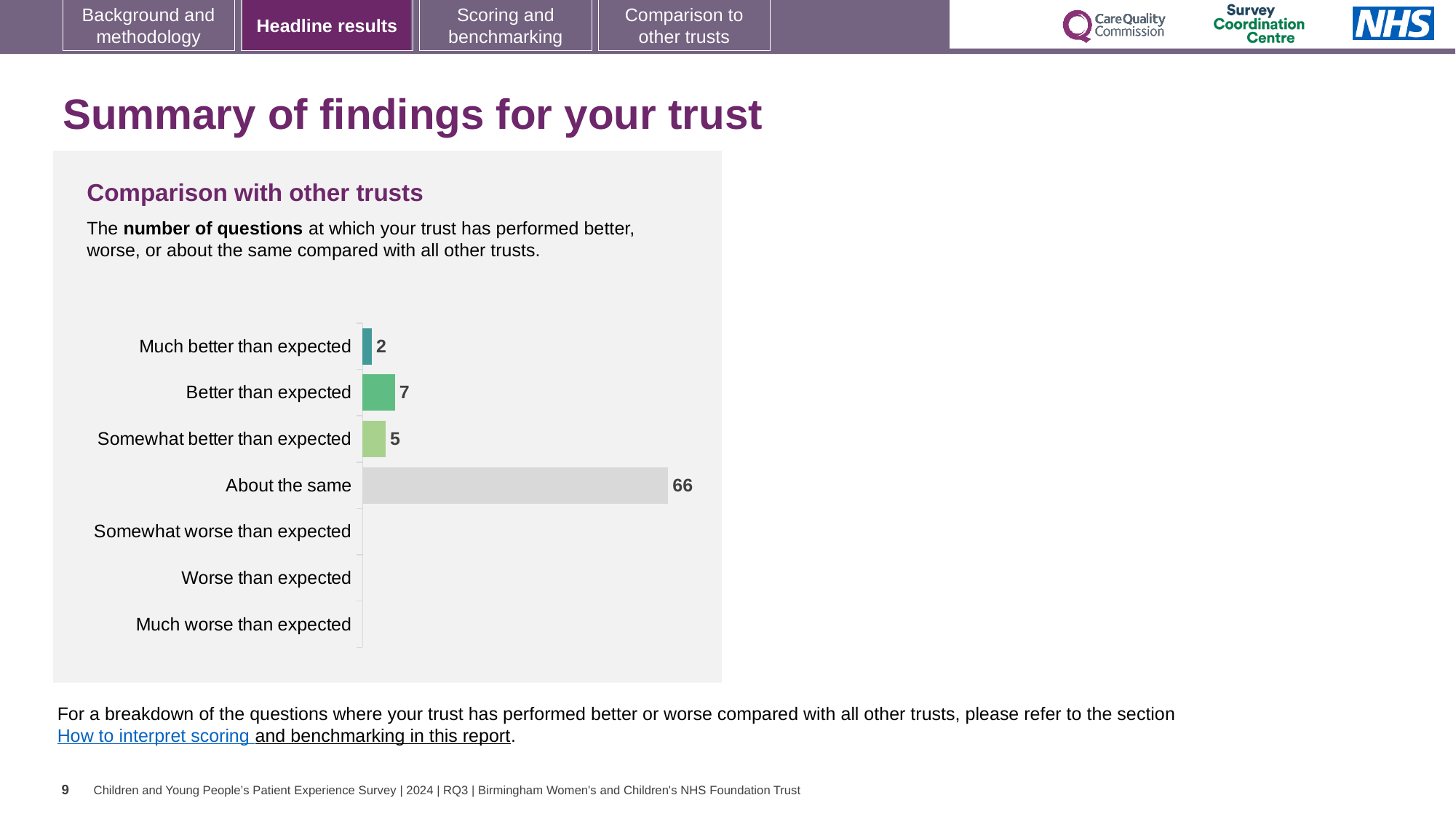
What is the value for 'Somewhat better than expected'? 5 What is the value for 'Better than expected'? 7 How many categories are listed on the chart? 7 What kind of chart is shown on the slide? Bar chart Which is larger, 'Better than expected' or 'Much better than expected'? Better than expected What is the value for 'Much better than expected'? 2 What is the difference between 'Better than expected' and 'Somewhat better than expected'? 2 What is the title of the chart? Comparison with other trusts How many questions were rated 'About the same'? 66 Which category has the highest value? About the same What is the difference between 'About the same' and 'Better than expected'? 59 What colour is the bar for 'About the same'? Grey